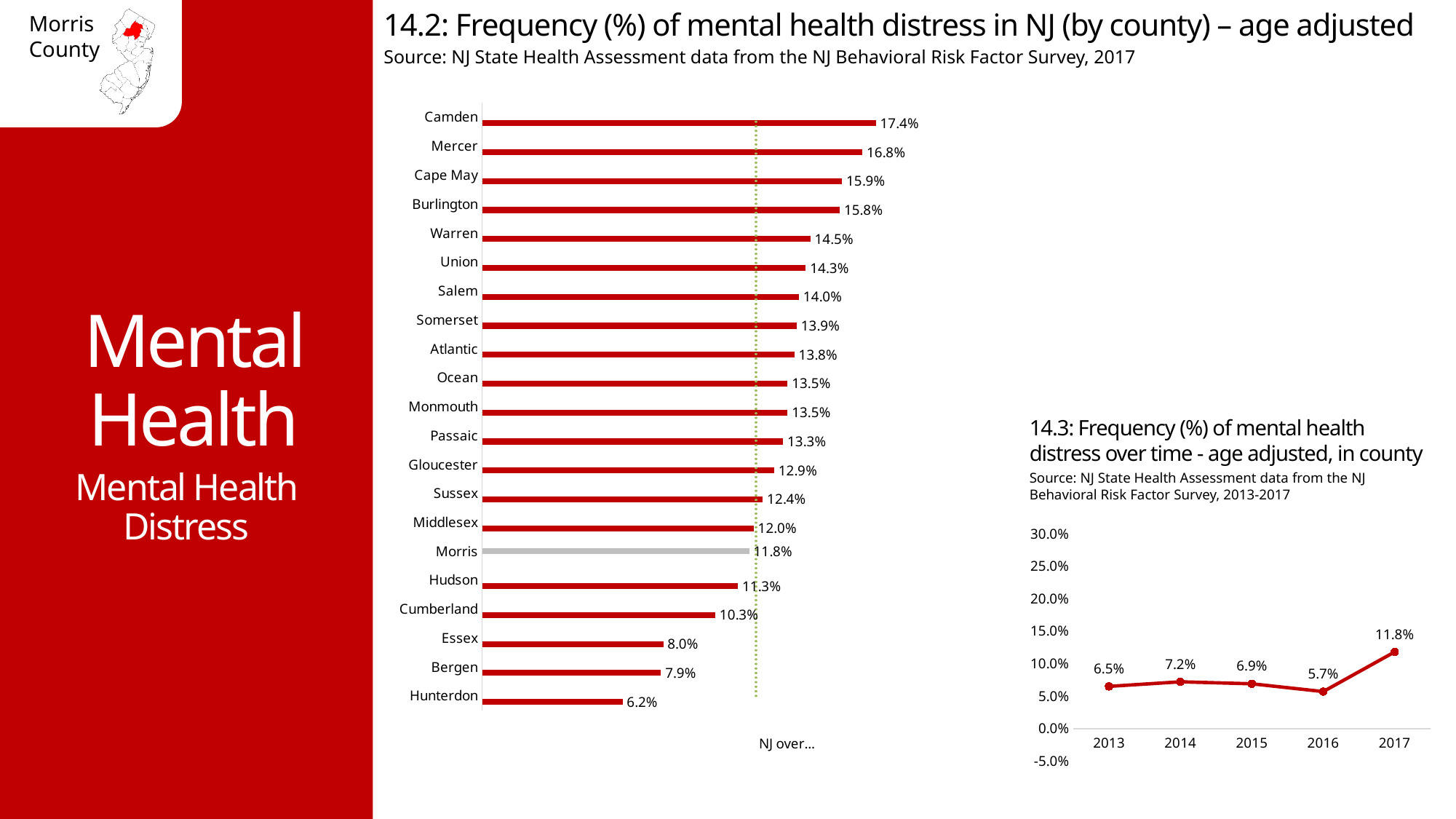
In chart 14.2 (frequency of mental health distress by county), what is the value for Morris? 11.8% In chart 14.2 (frequency of mental health distress by county), which county has the highest value? Camden In chart 14.2 (frequency of mental health distress by county), which county has the lowest value? Hunterdon In chart 14.3 (frequency of mental health distress over time), which year has the highest value? 2017 In chart 14.3 (frequency of mental health distress over time), what is the difference between the 2017 and 2016 values? 6.1% In chart 14.2 (frequency of mental health distress by county), what is the value for Cape May? 15.9% In chart 14.2 (frequency of mental health distress by county), how many counties are shown? 21 In chart 14.2 (frequency of mental health distress by county), what is the difference between Camden and Hunterdon? 11.2% What kind of chart is chart 14.2 (frequency of mental health distress by county)? Bar chart What kind of chart is chart 14.3 (frequency of mental health distress over time)? Line chart In chart 14.3 (frequency of mental health distress over time), what is the value for 2016? 5.7% In chart 14.2 (frequency of mental health distress by county), which is larger, the value for Essex or the value for Bergen? Essex